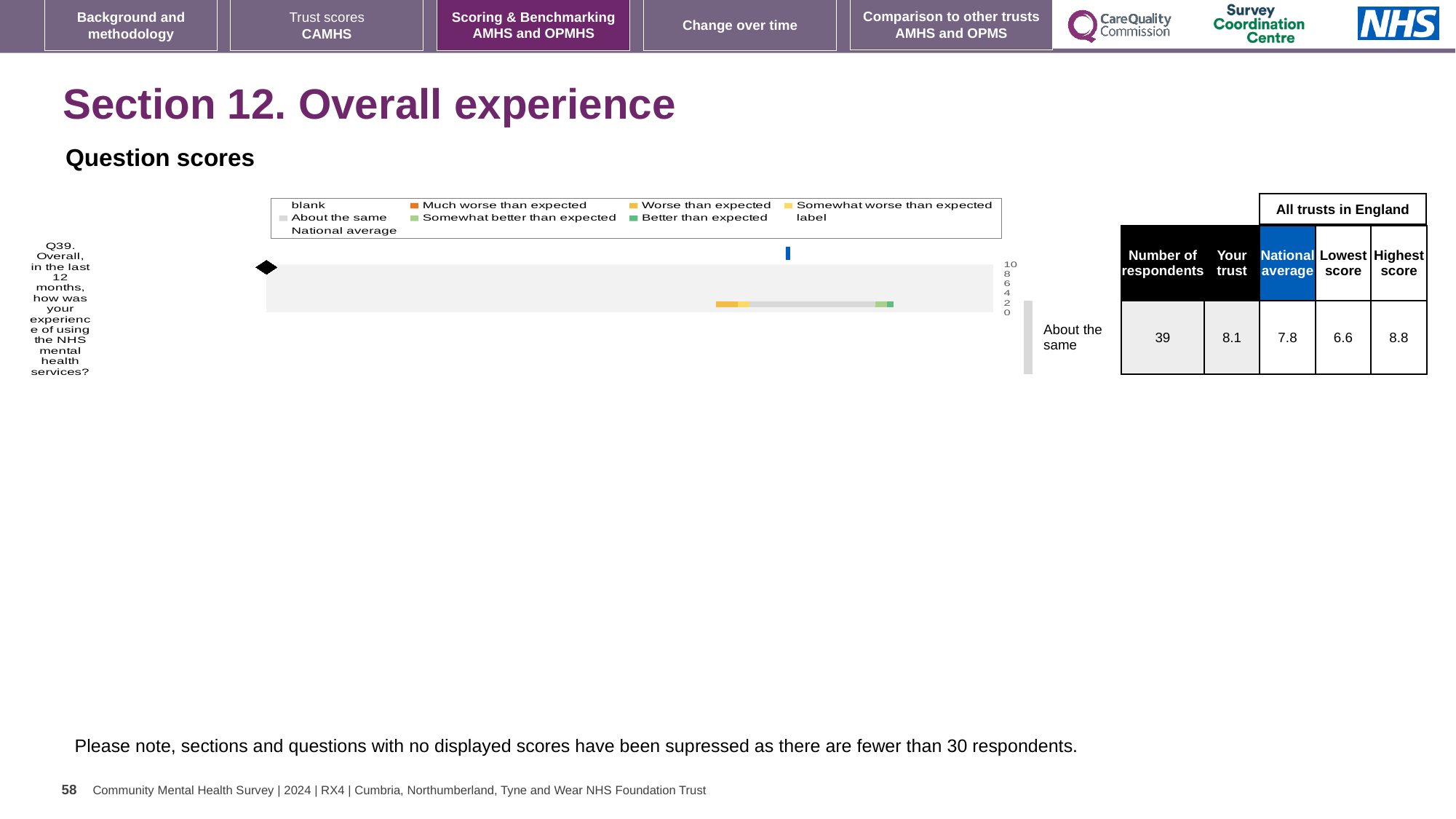
Is the 'Your trust' score for Q39 larger or smaller than the National average? larger What benchmark category label is shown beside the Q39 bar? About the same Which question is plotted in the question scores chart? Q39. Overall, in the last 12 months, how was your experience of using the NHS mental health services? How many questions (categories) are plotted in the question scores chart? 1 What is the difference between the 'Your trust' score and the National average for Q39? 0.3 In the table next to the chart, what is the National average score for Q39? 7.8 In the table next to the chart, how many respondents answered Q39? 39 What is the highest value shown on the chart's score axis? 10 In the table next to the chart, what is the Highest score among all trusts in England for Q39? 8.8 What kind of chart is used to show the Q39 question score? bar chart In the table next to the chart, what is the 'Your trust' score for Q39? 8.1 In the table next to the chart, what is the Lowest score among all trusts in England for Q39? 6.6